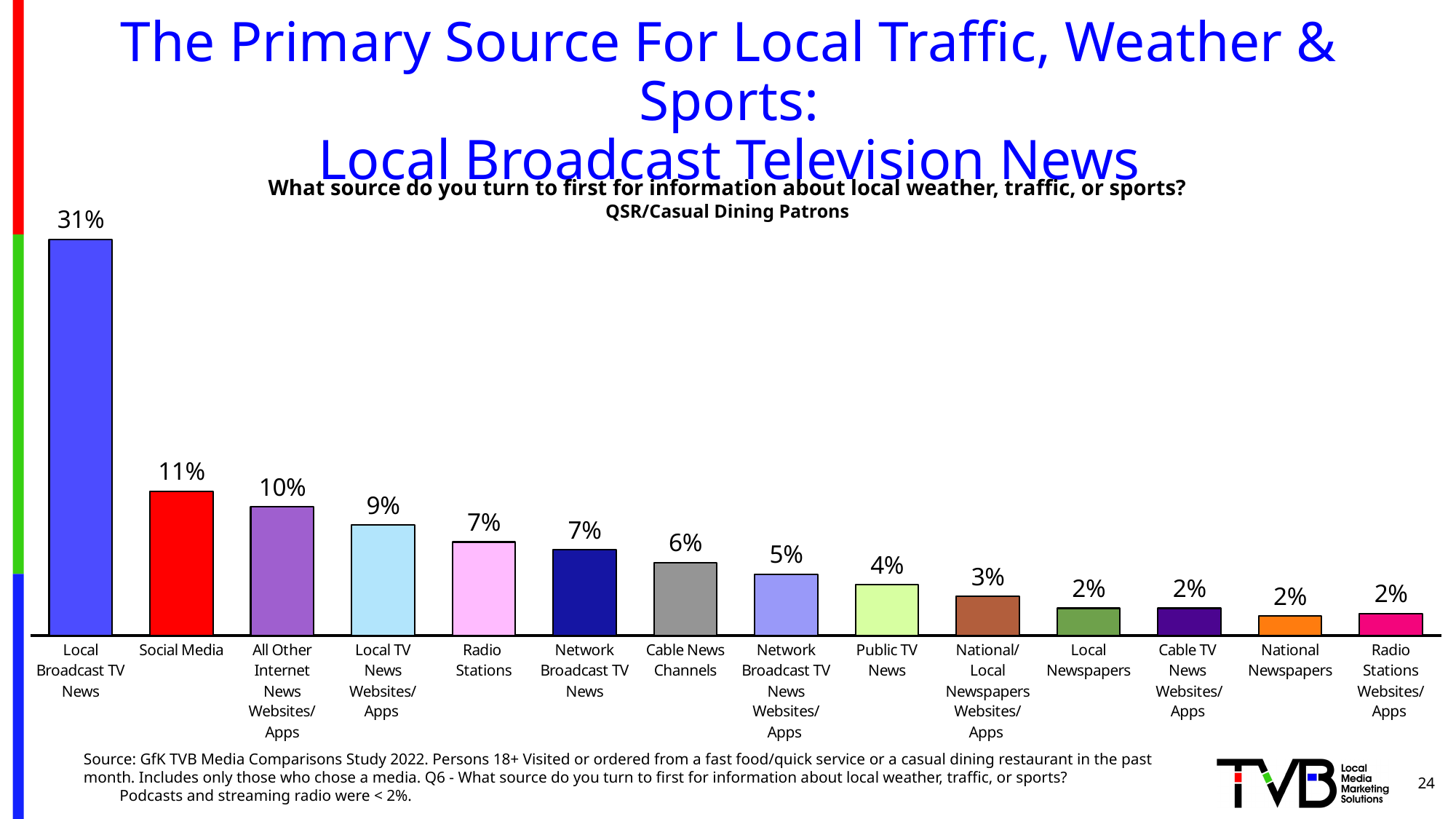
What is the value shown for Social Media? 11% What kind of chart is shown on the slide? Bar chart What is the value shown for Cable News Channels? 6% How many sources (bars) are shown on the chart? 14 Do the values rise or fall moving from left to right across the chart? Fall Which is larger, the value for Local TV News Websites/Apps or the value for Network Broadcast TV News? Local TV News Websites/Apps What is the value shown for Public TV News? 4% Which source has the highest percentage on the chart? Local Broadcast TV News What percentage of QSR/Casual Dining Patrons turn first to Local Broadcast TV News for local weather, traffic, or sports? 31% What is the difference in percentage points between Local Broadcast TV News and Social Media? 20 Which group of respondents does the chart describe, according to the subtitle? QSR/Casual Dining Patrons What is the difference in percentage points between All Other Internet News Websites/Apps and Radio Stations? 3